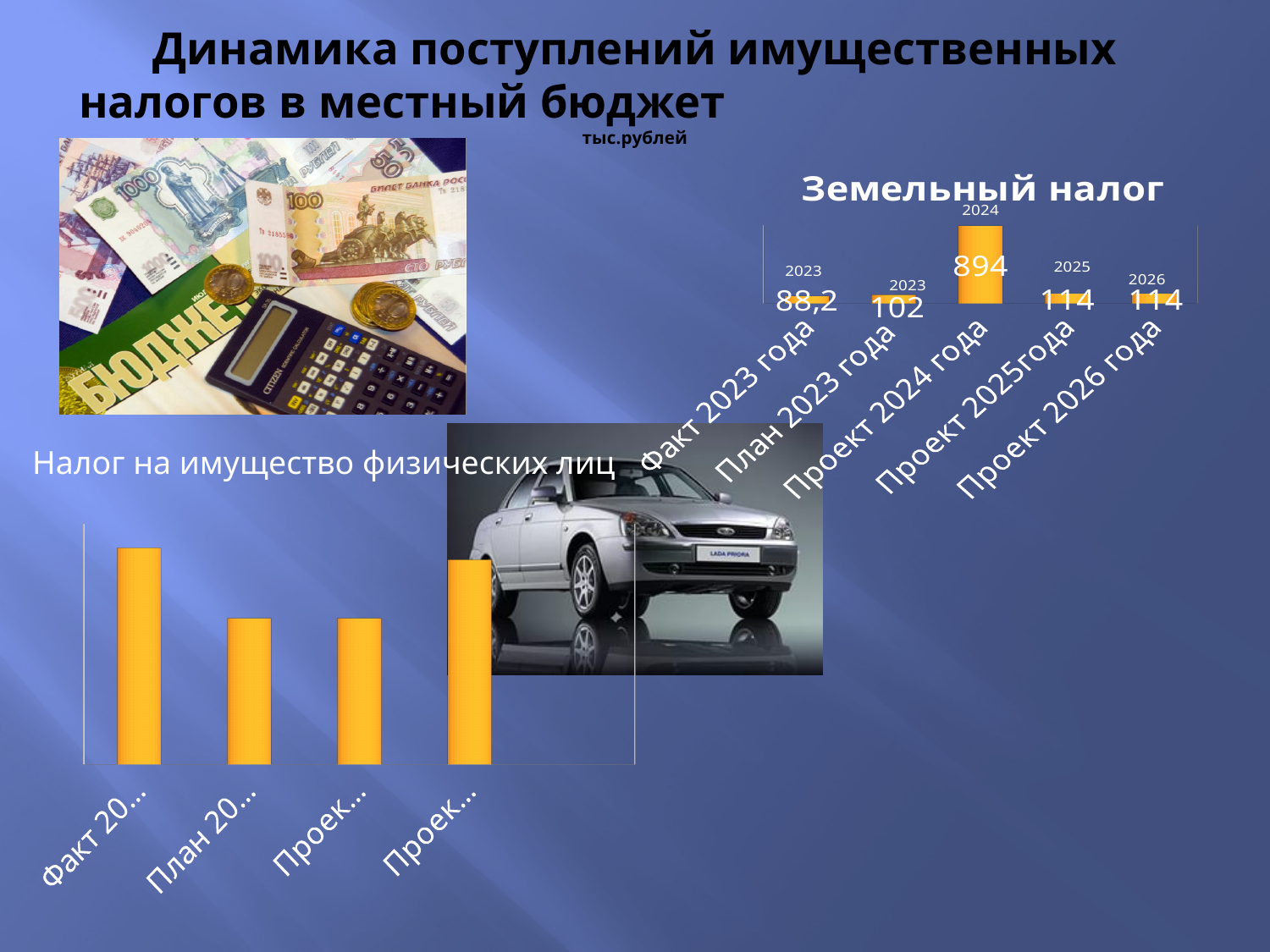
What kind of chart is the Земельный налог chart? Bar chart On the Земельный налог chart, what is the difference between Проект 2024 года and План 2023 года? 792 On the Земельный налог chart, which is larger: Проект 2025года or План 2023 года? Проект 2025года On the Земельный налог chart, what is the value for План 2023 года? 102 On the Земельный налог chart, what is the difference between План 2023 года and Факт 2023 года? 13,8 How many categories does the Земельный налог chart show? 5 What is the unit of measurement stated on the slide for the charts? тыс.рублей On the Земельный налог chart, what is the value for Проект 2026 года? 114 On the Земельный налог chart, what is the value for Проект 2024 года? 894 On the Земельный налог chart, what is the value for Факт 2023 года? 88,2 On the Земельный налог chart, which category has the lowest value? Факт 2023 года On the Земельный налог chart, which category has the highest value? Проект 2024 года